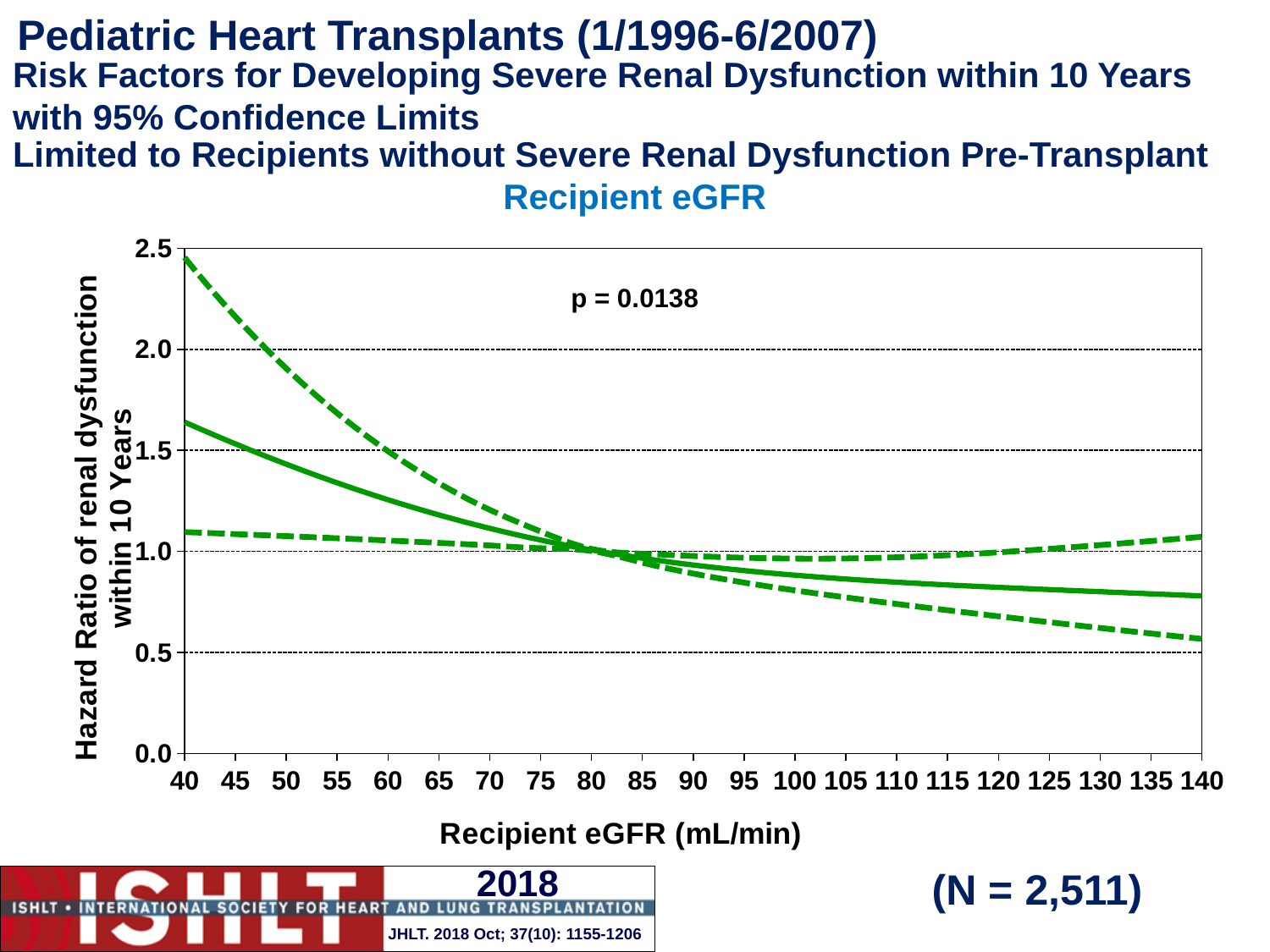
Is the upper dashed confidence limit at a Recipient eGFR of 140 mL/min greater or less than 1.0? greater What kind of chart is shown on the slide? line chart How many lines are plotted on the chart? 3 How many tick labels are shown on the x axis? 21 As Recipient eGFR increases from 40 to 140 mL/min, does the solid hazard ratio line rise or fall? fall Is the hazard ratio on the solid line larger at a Recipient eGFR of 40 mL/min or at 140 mL/min? 40 mL/min Is the lower dashed confidence limit at a Recipient eGFR of 140 mL/min greater or less than 0.5? greater What p-value is printed on the chart? p = 0.0138 What is the N shown on the slide? N = 2,511 Is the hazard ratio on the solid line at a Recipient eGFR of 140 mL/min greater or less than 1.0? less